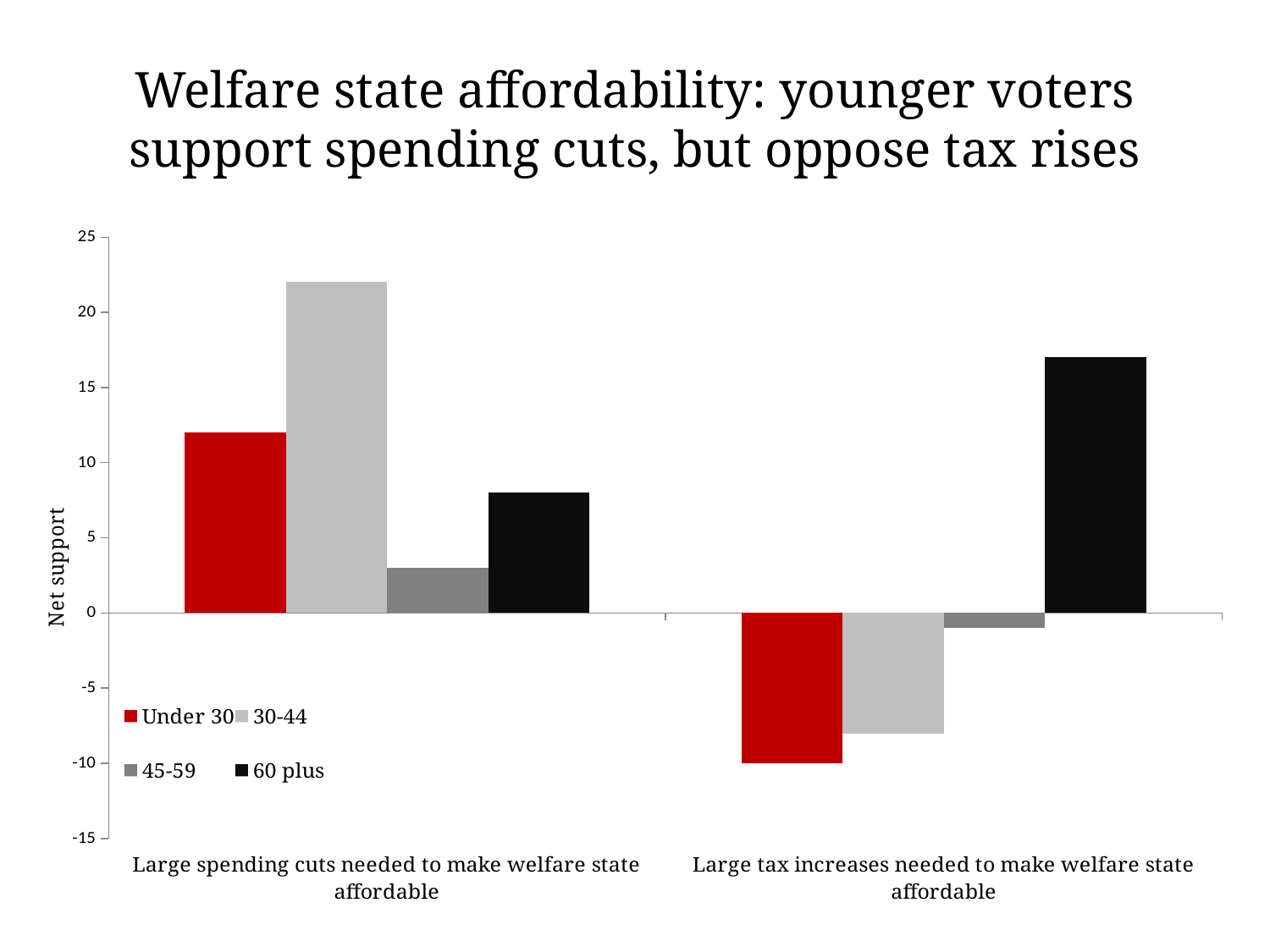
Is the net support of the 60 plus group for 'Large tax increases needed to make welfare state affordable' greater or less than 15? greater Which age group has the lowest net support for 'Large tax increases needed to make welfare state affordable'? Under 30 How many categories are shown on the x axis? 2 Which age group has the highest net support for 'Large tax increases needed to make welfare state affordable'? 60 plus Which age group has the lowest net support for 'Large spending cuts needed to make welfare state affordable'? 45-59 For 'Large spending cuts needed to make welfare state affordable', which has higher net support: Under 30 or 60 plus? Under 30 Which age group has the highest net support for 'Large spending cuts needed to make welfare state affordable'? 30-44 What is the label on the vertical axis? Net support What kind of chart is shown on the slide? bar chart How many series does the legend list? 4 Is the net support of the 30-44 group for 'Large spending cuts needed to make welfare state affordable' greater or less than 20? greater Which age group is shown in red in the legend? Under 30